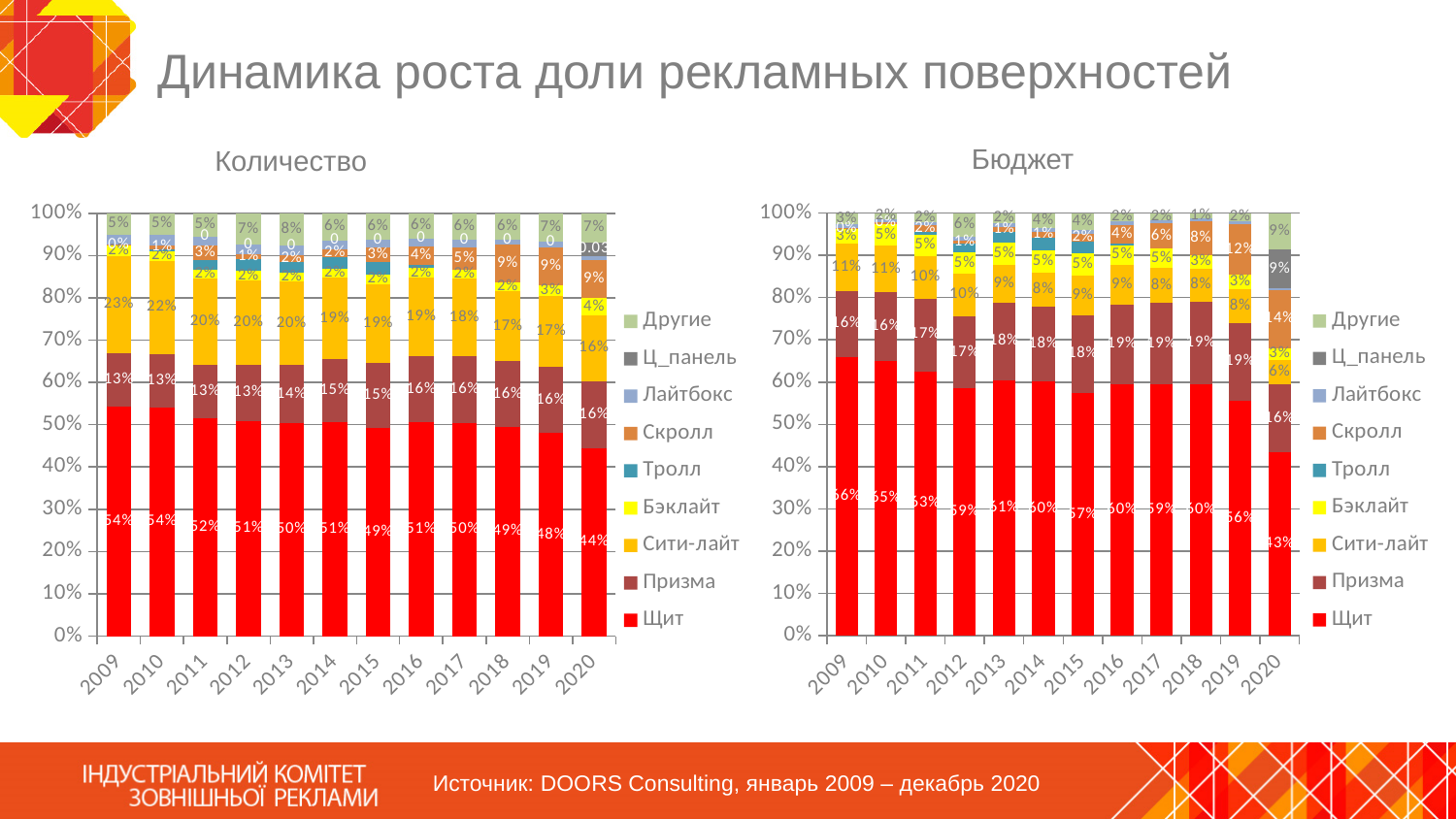
In the "Бюджет" chart, what is the value for Призма in 2013? 18% How many years are shown on the x axis of the "Бюджет" chart? 12 In the "Количество" chart, what is the value for Сити-лайт in 2009? 23% In the "Бюджет" chart, what is the value for Щит in 2020? 43% How many series does the legend of the "Количество" chart list? 9 In the "Количество" chart, what is the difference between the Щит values for 2009 and 2020? 10% In the "Количество" chart, what is the value for Щит in 2020? 44% In the "Бюджет" chart, which year has the lowest value for Щит? 2020 In the "Количество" chart, what is the value for Щит in 2009? 54% In the "Бюджет" chart, what is the value for Щит in 2009? 66% In the "Количество" chart, which is larger in 2009: Сити-лайт or Призма? Сити-лайт What kind of chart is the "Бюджет" chart? Stacked bar chart